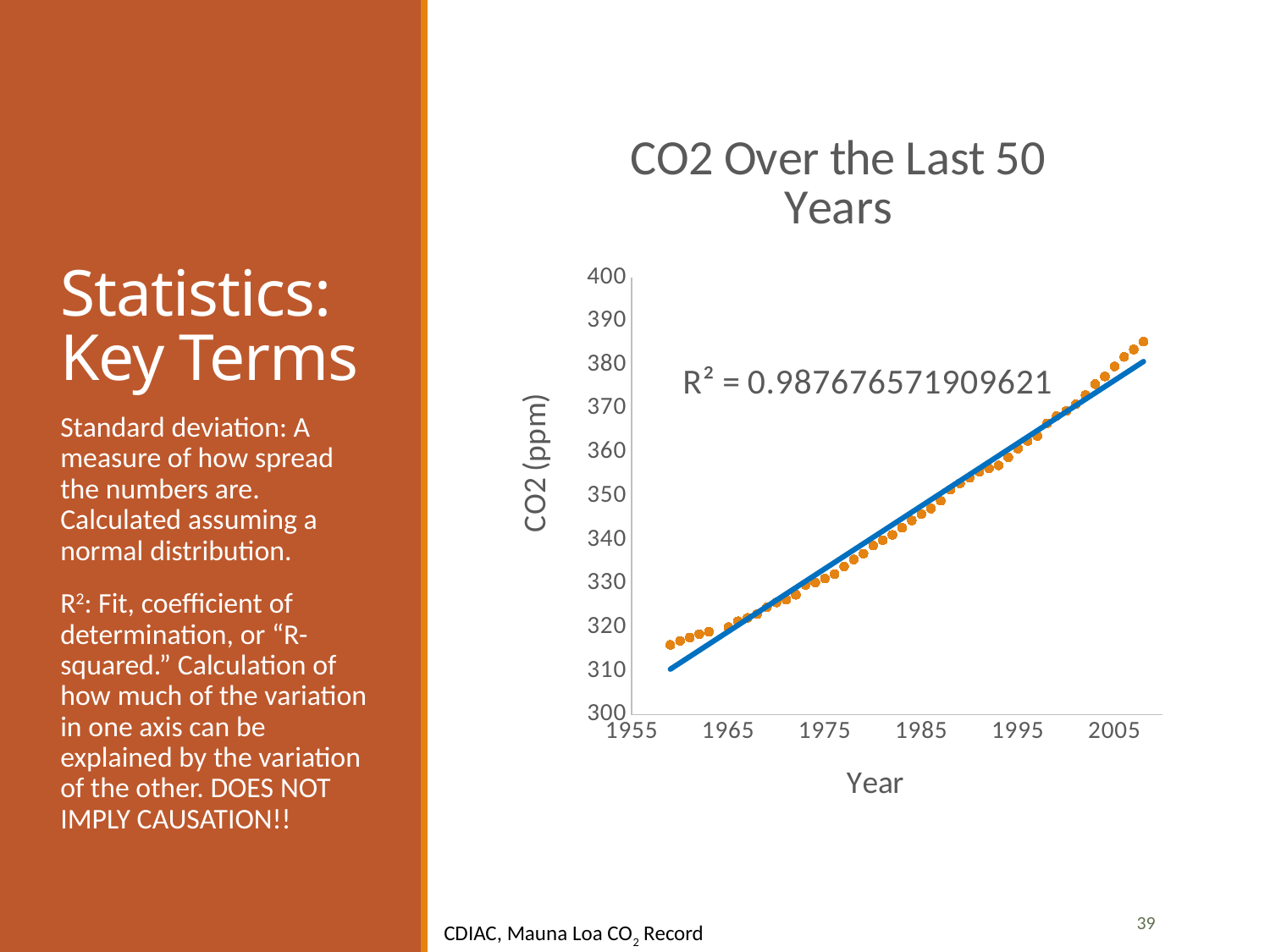
Is the CO2 value for 1975 greater or less than 340? less What R² value is printed on the chart? R² = 0.987676571909621 Which is larger, the CO2 value for 1965 or the CO2 value for 1995? 1995 Is the CO2 value for 1985 greater or less than 340? greater Is the CO2 value for 1995 greater or less than 350? greater Do the CO2 values rise or fall as the year increases? rise What is the title of the chart? CO2 Over the Last 50 Years What kind of chart is shown on the slide? scatter chart